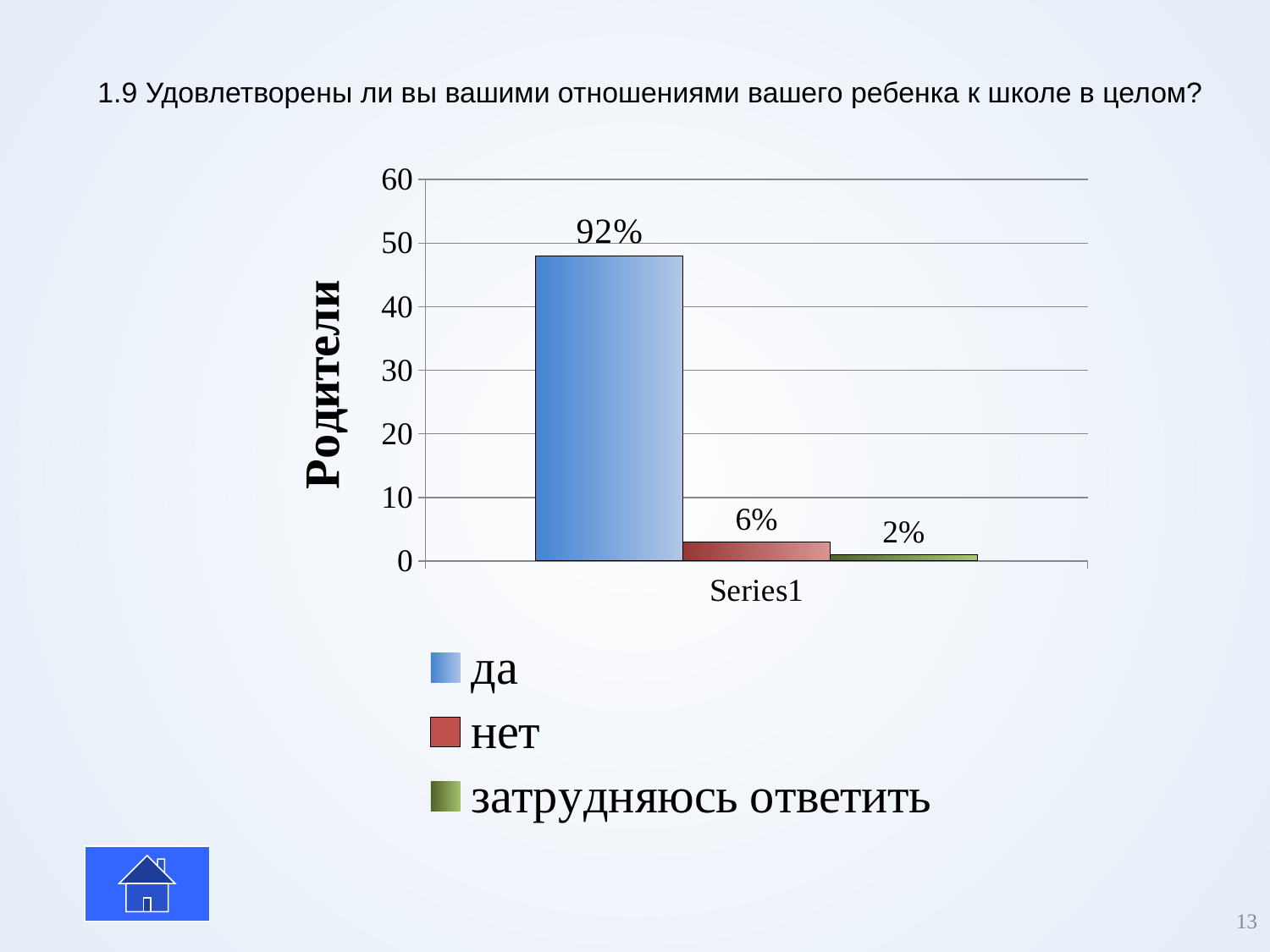
Is the bar for "да" greater or less than 40 on the vertical axis? greater Is the bar for "нет" greater or less than 10 on the vertical axis? less Which is larger, the value for "нет" or the value for "затрудняюсь ответить"? нет How many series does the legend list? 3 What kind of chart is shown on the slide? bar chart Which legend entry has the lowest value? затрудняюсь ответить Which legend entry has the highest value? да What is the title of the vertical axis? Родители What is the data label on the bar for "затрудняюсь ответить"? 2% What is the data label on the bar for "да"? 92% What is the difference between the labelled values for "да" and "нет"? 86% What is the data label on the bar for "нет"? 6%